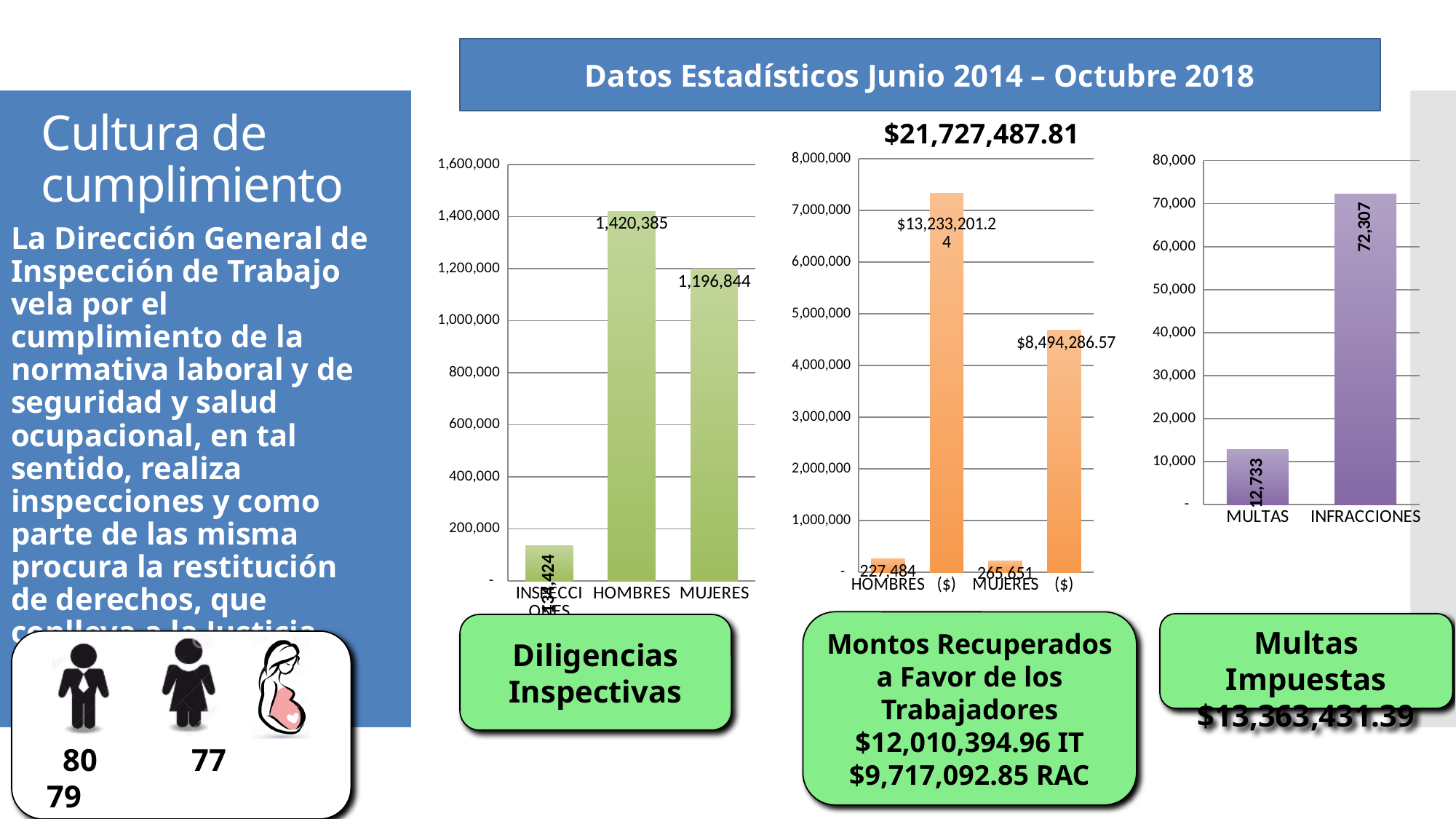
In the Diligencias Inspectivas chart, what is the difference between the HOMBRES and MUJERES values? 223,541 In the Multas Impuestas chart, what is the value for INFRACCIONES? 72,307 In the Diligencias Inspectivas chart, which category has the lowest value? INSPECCIONES In the Montos Recuperados chart, what is the dollar amount shown for MUJERES ($)? $8,494,286.57 In the Diligencias Inspectivas chart, is the value for INSPECCIONES greater or less than 200,000? less In the Montos Recuperados chart, which is larger: the HOMBRES count (227,484) or the MUJERES count (265,651)? MUJERES What type of chart is the Multas Impuestas chart? bar chart In the Multas Impuestas chart, what is the difference between INFRACCIONES and MULTAS? 59,574 In the Diligencias Inspectivas chart, what is the value for HOMBRES? 1,420,385 In the Diligencias Inspectivas chart, what is the value for MUJERES? 1,196,844 In the Diligencias Inspectivas chart, which category has the highest value? HOMBRES In the Montos Recuperados chart, what is the dollar amount shown for HOMBRES ($)? $13,233,201.24